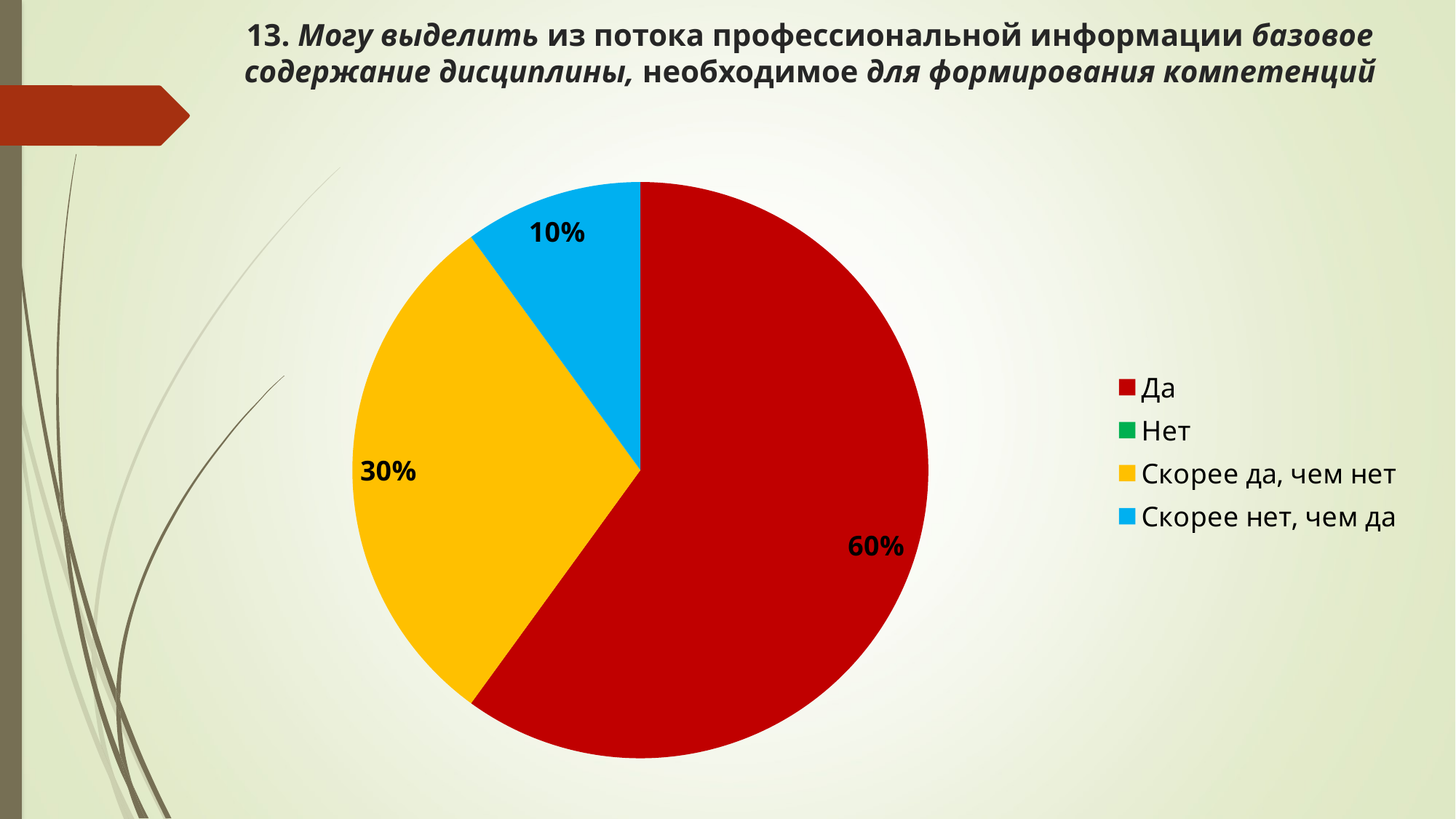
Which is larger: the share for "Скорее да, чем нет" or the share for "Скорее нет, чем да"? Скорее да, чем нет What is the difference between the shares for "Скорее да, чем нет" and "Скорее нет, чем да"? 20% What share of the pie does "Да" represent? 60% Which of the visible slices is the smallest? Скорее нет, чем да How many entries does the legend list? 4 What colour is the slice for "Скорее нет, чем да"? Blue Which category has the largest slice of the pie? Да What kind of chart is shown on the slide? Pie chart What share of the pie does "Скорее да, чем нет" represent? 30% Which legend entry has no visible slice in the pie? Нет What is the difference between the shares for "Да" and "Скорее да, чем нет"? 30% What share of the pie does "Скорее нет, чем да" represent? 10%